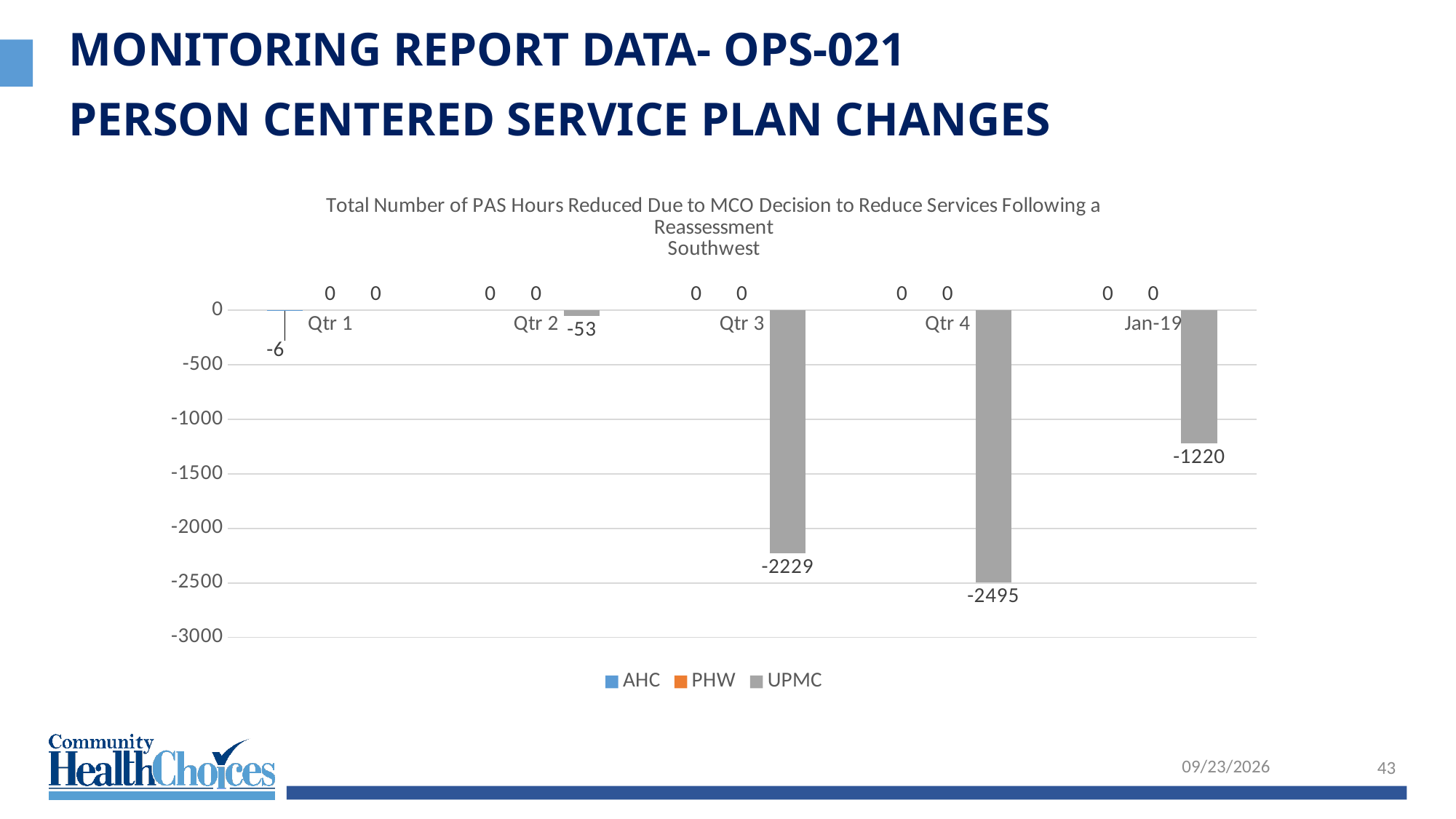
How many series does the legend list? 3 How many periods are shown on the x axis? 5 What kind of chart is shown on the slide? Bar chart What is the AHC value for Qtr 1? -6 What is the difference between the UPMC values for Qtr 4 and Qtr 3? 266 In which period does UPMC have the lowest (most negative) value? Qtr 4 What is the UPMC value for Qtr 2? -53 What is the UPMC value for Qtr 3? -2229 What is the UPMC value for Jan-19? -1220 Which is more negative for UPMC, Qtr 3 or Jan-19? Qtr 3 What is the PHW value for Qtr 3? 0 What is the UPMC value for Qtr 4? -2495